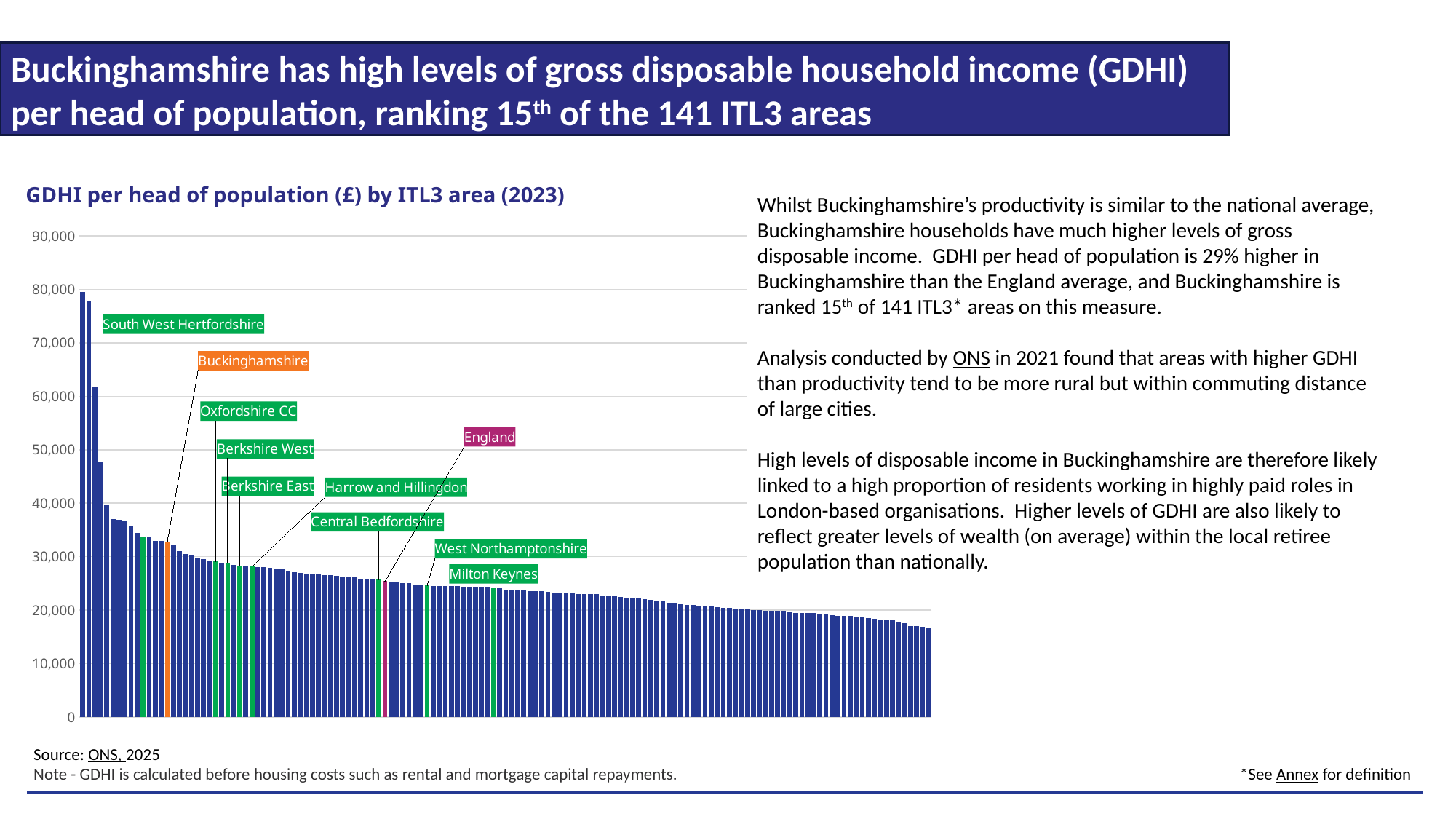
Is the value for Central Bedfordshire greater or less than 20,000? greater Do the bar values rise or fall from left to right across the chart? Fall Is the value for Buckinghamshire greater or less than 40,000? less Is the value for Milton Keynes greater or less than 30,000? less What colour is the bar for Buckinghamshire? Orange What kind of chart is shown on the slide? Bar chart Which has the higher GDHI per head, Buckinghamshire or Milton Keynes? Buckinghamshire What is the title of the chart? GDHI per head of population (£) by ITL3 area (2023) Which has the higher GDHI per head, Buckinghamshire or England? Buckinghamshire